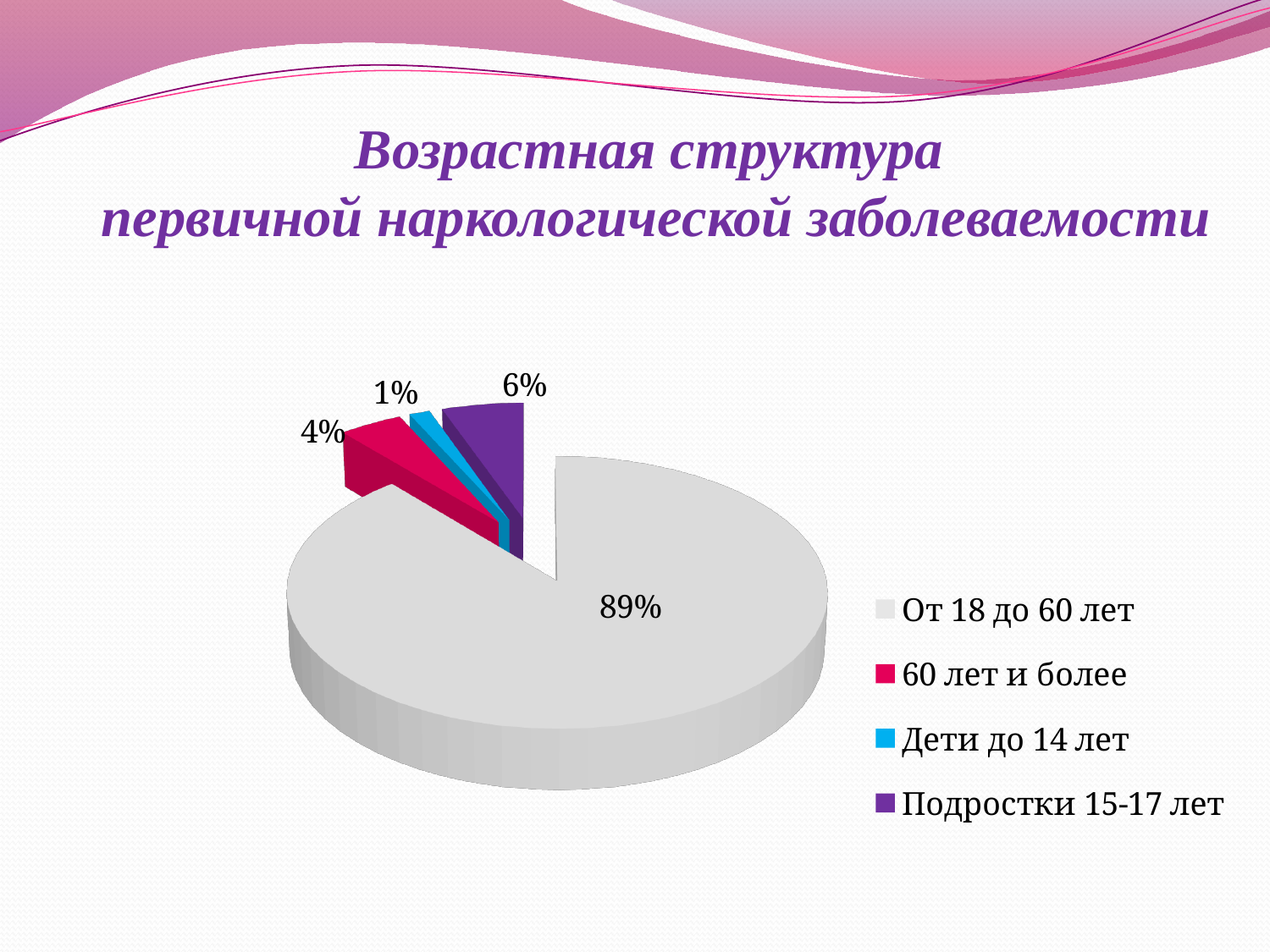
Which category has the largest slice of the pie? От 18 до 60 лет What is the difference between the values for "Подростки 15-17 лет" and "60 лет и более"? 2% What is the value shown for "60 лет и более"? 4% Which category has the smallest slice of the pie? Дети до 14 лет Which is larger, the value for "60 лет и более" or the value for "Подростки 15-17 лет"? Подростки 15-17 лет What kind of chart is shown on the slide? Pie chart How many categories does the pie chart have? 4 Which category is shown in purple in the legend? Подростки 15-17 лет What is the title of the chart on the slide? Возрастная структура первичной наркологической заболеваемости What is the value shown for "Подростки 15-17 лет"? 6% What is the value shown for "Дети до 14 лет"? 1% What share of the pie does the "От 18 до 60 лет" slice have? 89%